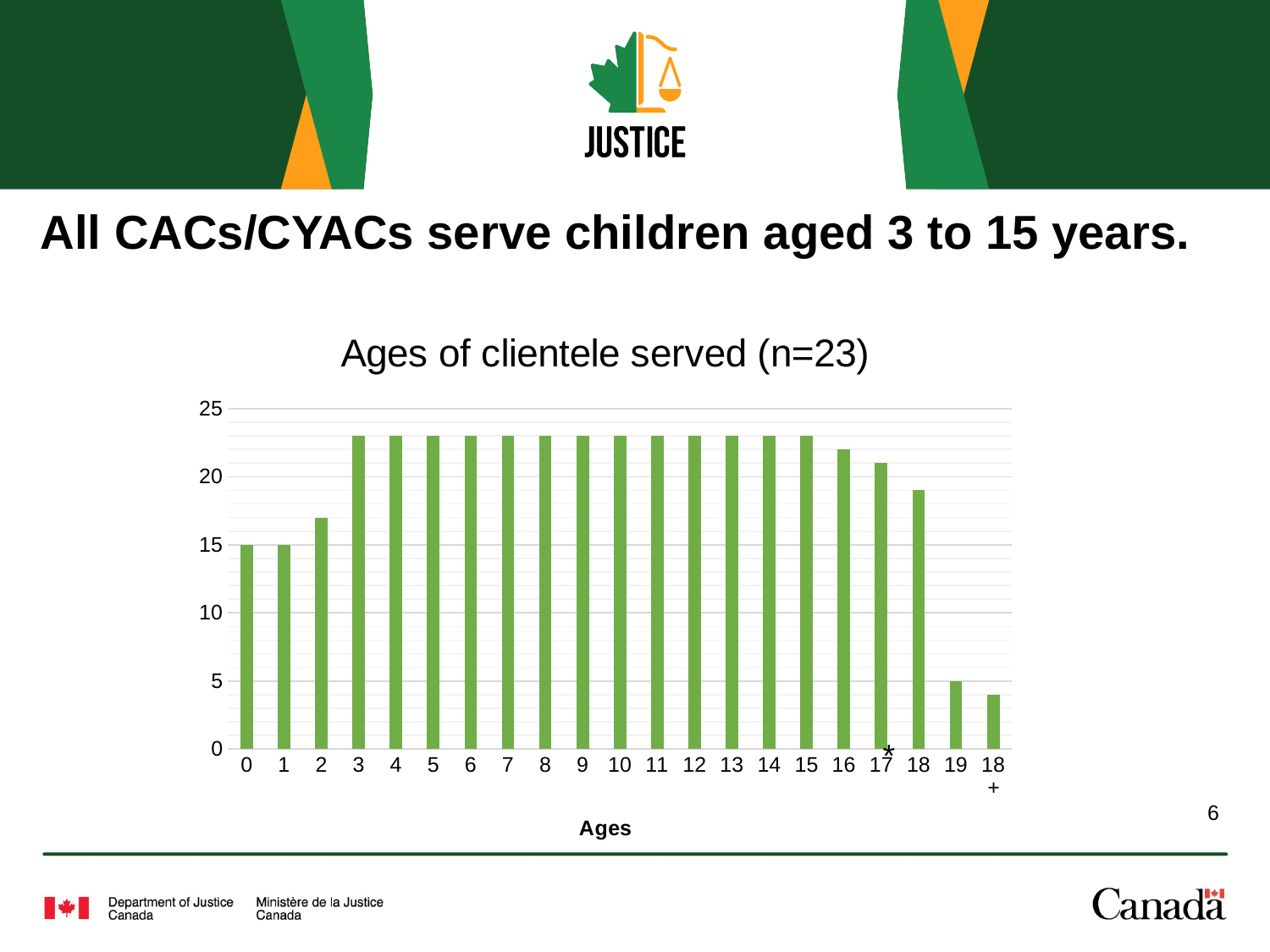
Do the values rise or fall from age 15 to age 18+? fall What kind of chart is shown on the slide? bar chart Is the value for age 18 greater or less than 20? less What is the label on the x axis of the chart? Ages Is the value for age 18+ greater or less than 5? less Is the value for age 2 greater or less than 15? greater Which has the larger value, age 16 or age 18? age 16 How many age categories are shown on the x axis of the chart? 21 Which has the larger value, age 0 or age 2? age 2 What is the title of the chart? Ages of clientele served (n=23)